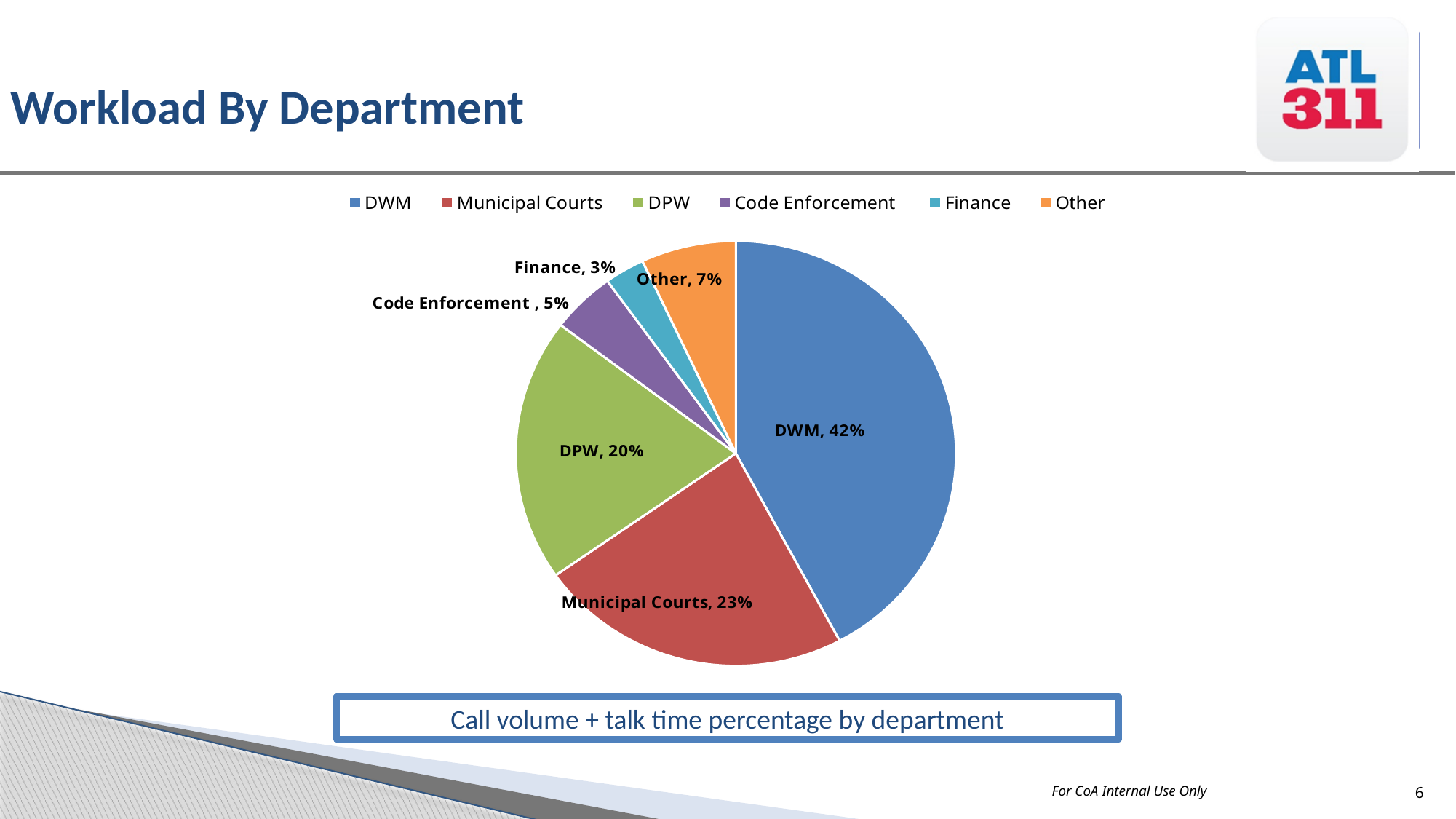
Which department has the largest share of the workload? DWM What is the title of the slide containing the chart? Workload By Department What percentage of the workload is attributed to Municipal Courts? 23% Which department has the smallest share of the workload? Finance Which has a larger share of the workload, DPW or Other? DPW What type of chart is shown on the slide? Pie chart What percentage of the workload is attributed to DWM? 42% How many departments are shown in the pie chart? 6 What is the difference in percentage points between DWM and Municipal Courts? 19 What percentage of the workload is attributed to Finance? 3% What percentage of the workload is attributed to Code Enforcement? 5% What percentage of the workload is attributed to DPW? 20%